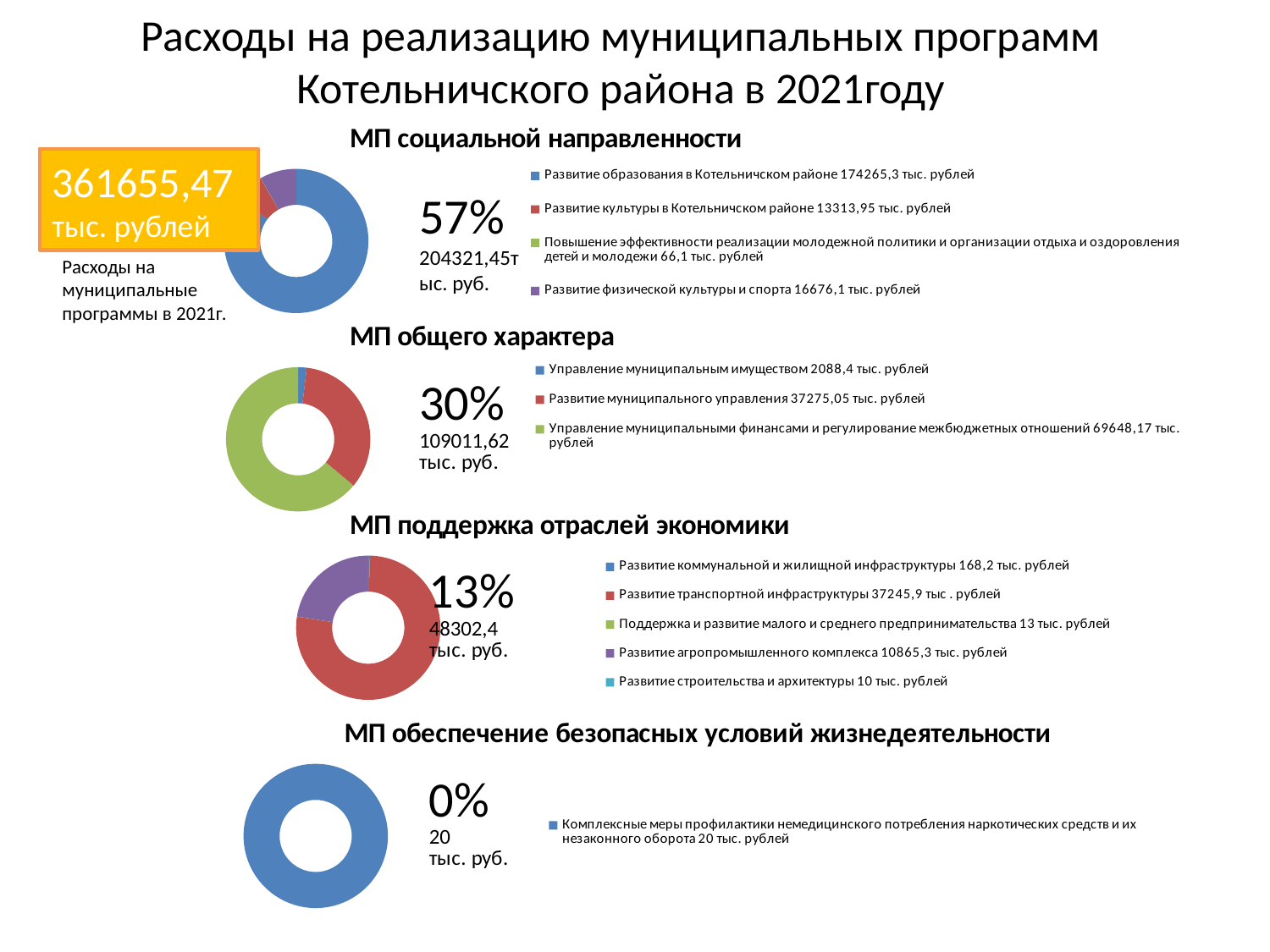
In the "МП поддержка отраслей экономики" chart, what is the value for "Развитие строительства и архитектуры"? 10 тыс. рублей In the "МП социальной направленности" chart, which category has the lowest value? Повышение эффективности реализации молодежной политики и организации отдыха и оздоровления детей и молодежи In the "МП социальной направленности" chart, what is the value for "Развитие образования в Котельничском районе"? 174265,3 тыс. рублей In the "МП социальной направленности" chart, what is the difference between "Развитие образования в Котельничском районе" and "Развитие культуры в Котельничском районе"? 160951,35 тыс. рублей In the "МП общего характера" chart, which category has the highest value? Управление муниципальными финансами и регулирование межбюджетных отношений In the "МП общего характера" chart, what is the difference between "Развитие муниципального управления" and "Управление муниципальным имуществом"? 35186,65 тыс. рублей In the "МП поддержка отраслей экономики" chart, how many categories does the legend list? 5 In the "МП общего характера" chart, what is the value for "Управление муниципальным имуществом"? 2088,4 тыс. рублей In the "МП социальной направленности" chart, how many categories does the legend list? 4 What kind of chart is used for "МП социальной направленности"? Doughnut chart In the "МП поддержка отраслей экономики" chart, which is larger: "Развитие транспортной инфраструктуры" or "Развитие агропромышленного комплекса"? Развитие транспортной инфраструктуры What percentage is printed next to the "МП обеспечение безопасных условий жизнедеятельности" chart? 0%